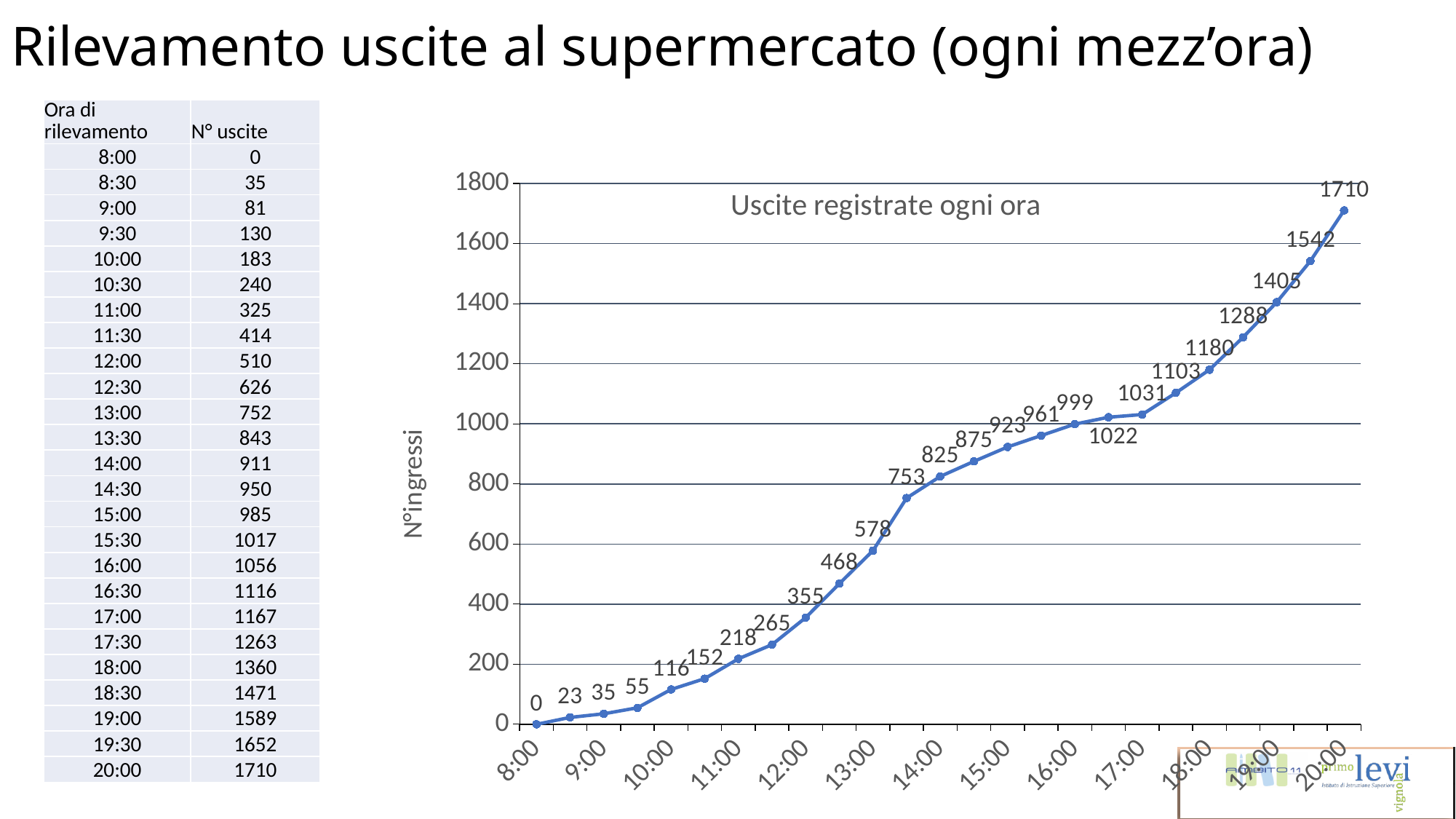
At which time does the chart reach its highest value? 20:00 Do the values in the chart rise or fall from 8:00 to 20:00? rise Which is larger in the chart, the value at 14:00 or the value at 12:00? 14:00 What kind of chart is shown on the slide? line chart What is the label on the vertical axis of the chart? N°ingressi What is the title of the chart? Uscite registrate ogni ora What is the value plotted at 20:00 in the chart? 1710 What is the value plotted at 17:00 in the chart? 1031 What is the difference between the values plotted at 20:00 and 19:00? 305 What is the value plotted at 10:00 in the chart? 116 What is the value plotted at 13:00 in the chart? 578 At which time does the chart show its lowest value? 8:00